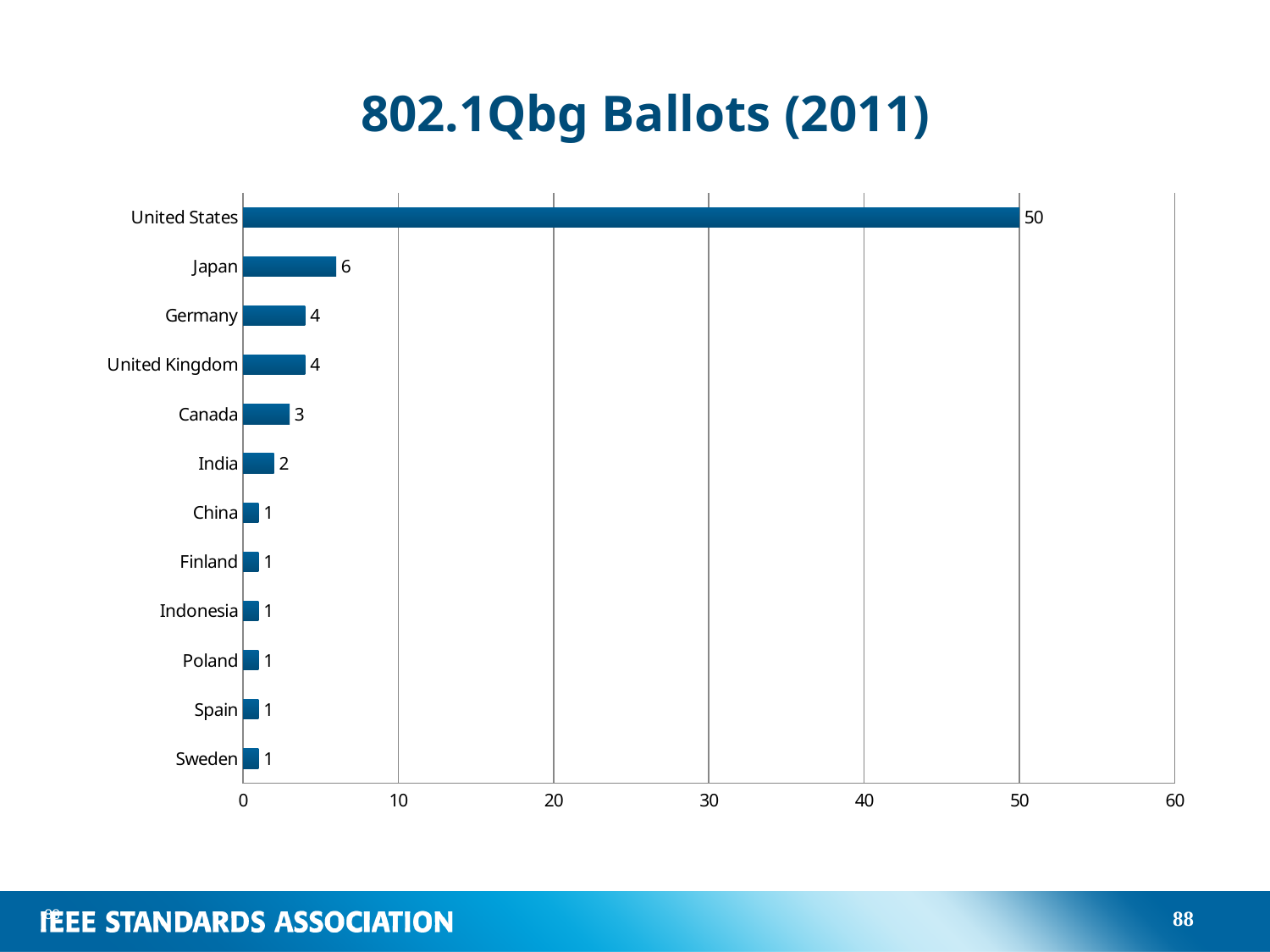
How many countries are shown in the chart? 12 What is the value for Canada? 3 What is the difference between the values for Japan and Germany? 2 Is the value for United States greater or less than 40? greater What is the value for India? 2 Which is larger, the value for Canada or the value for India? Canada Which country has the highest number of ballots? United States What kind of chart is shown on the slide? bar chart What is the value for United States? 50 What is the title of the chart? 802.1Qbg Ballots (2011) What is the value for Japan? 6 What is the difference between the values for United States and Japan? 44